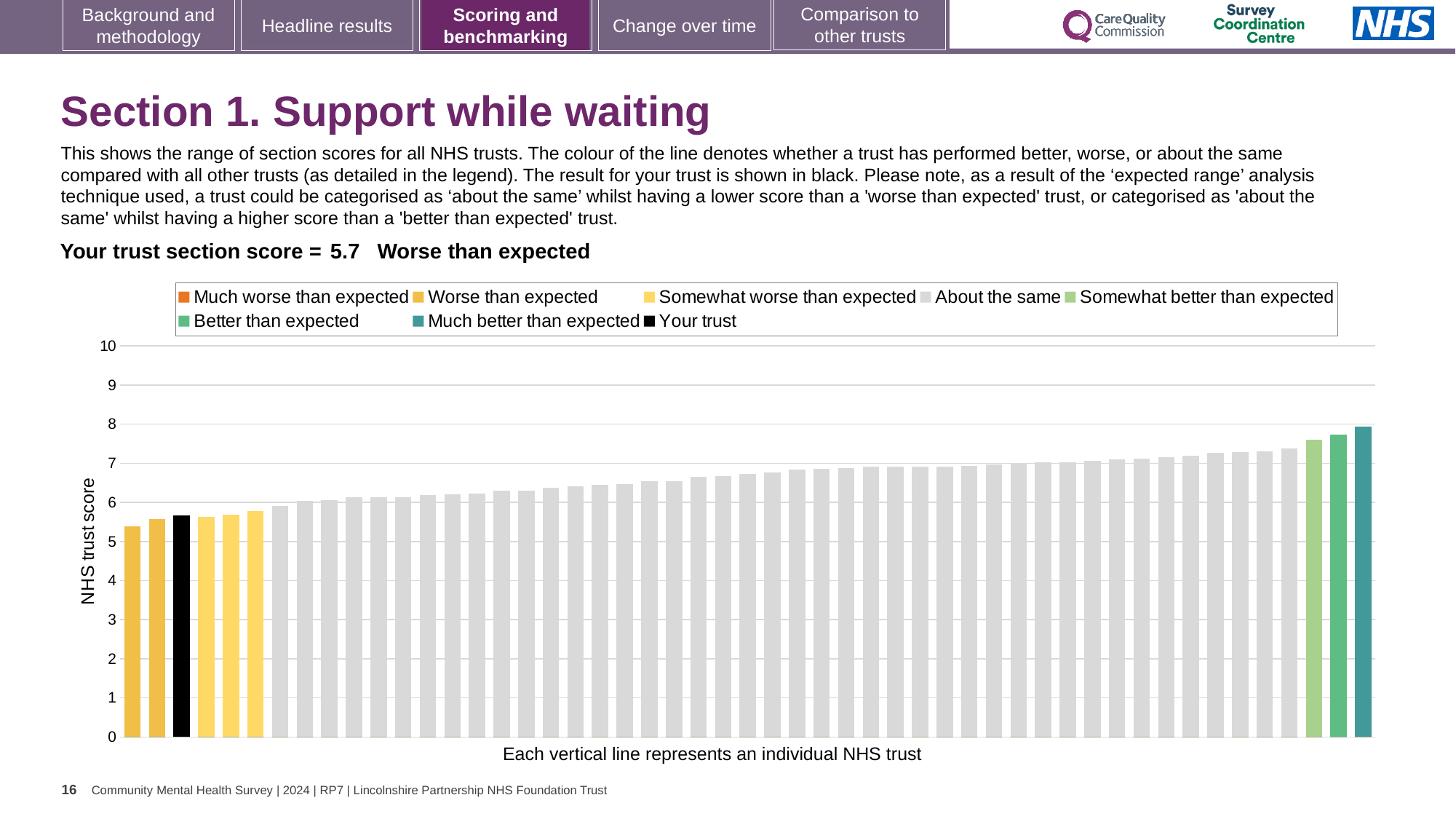
Is the value of the black 'Your trust' bar greater or less than 6? less What kind of chart is shown on the slide? Bar chart Do the bar values rise or fall from left to right along the x axis? Rise How many entries does the chart legend list? 8 What performance category is given for your trust's section score? Worse than expected Is the value of the tallest bar in the chart greater or less than 8? less What is the section score for your trust shown on the slide? 5.7 What is the label on the y axis of the chart? NHS trust score Which legend category does the tallest bar (rightmost) belong to? Much better than expected Is the value of the black 'Your trust' bar greater or less than 5? greater Is the black 'Your trust' bar higher or lower than the rightmost bar? Lower